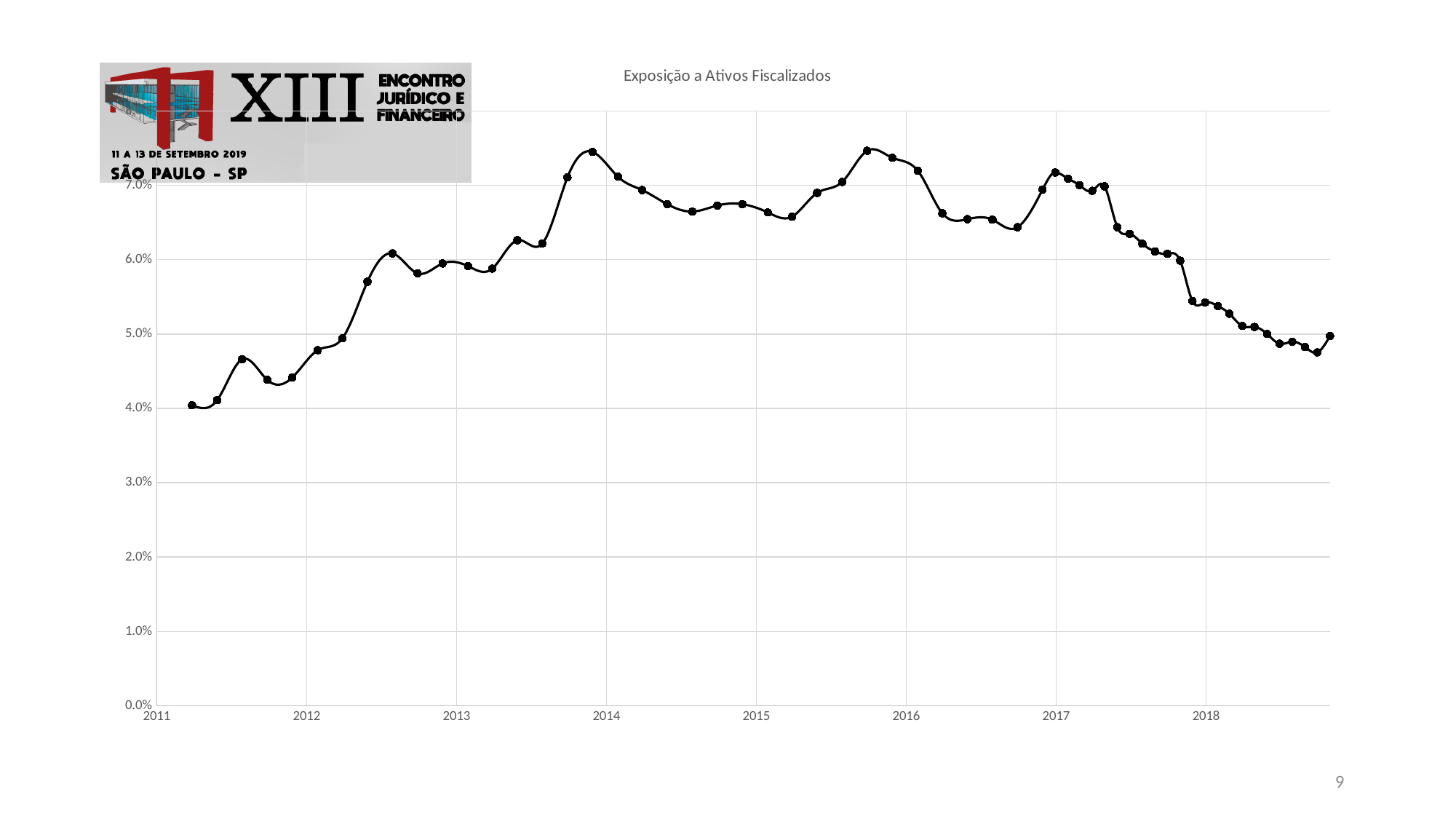
In which year does the line reach its lowest value? 2011 Is the value at the start of the series in 2011 greater or less than 5.0%? less Is the value at the start of 2015 greater or less than 7.0%? less What kind of chart is shown on the slide? line chart Does the line rise or fall between 2017 and 2018? fall Is the value at the start of 2016 greater or less than 7.0%? greater Does the line rise or fall between 2011 and 2014? rise Which is larger: the value at the start of 2011 or the value at the start of 2016? the value at the start of 2016 What is the title of the chart? Exposição a Ativos Fiscalizados